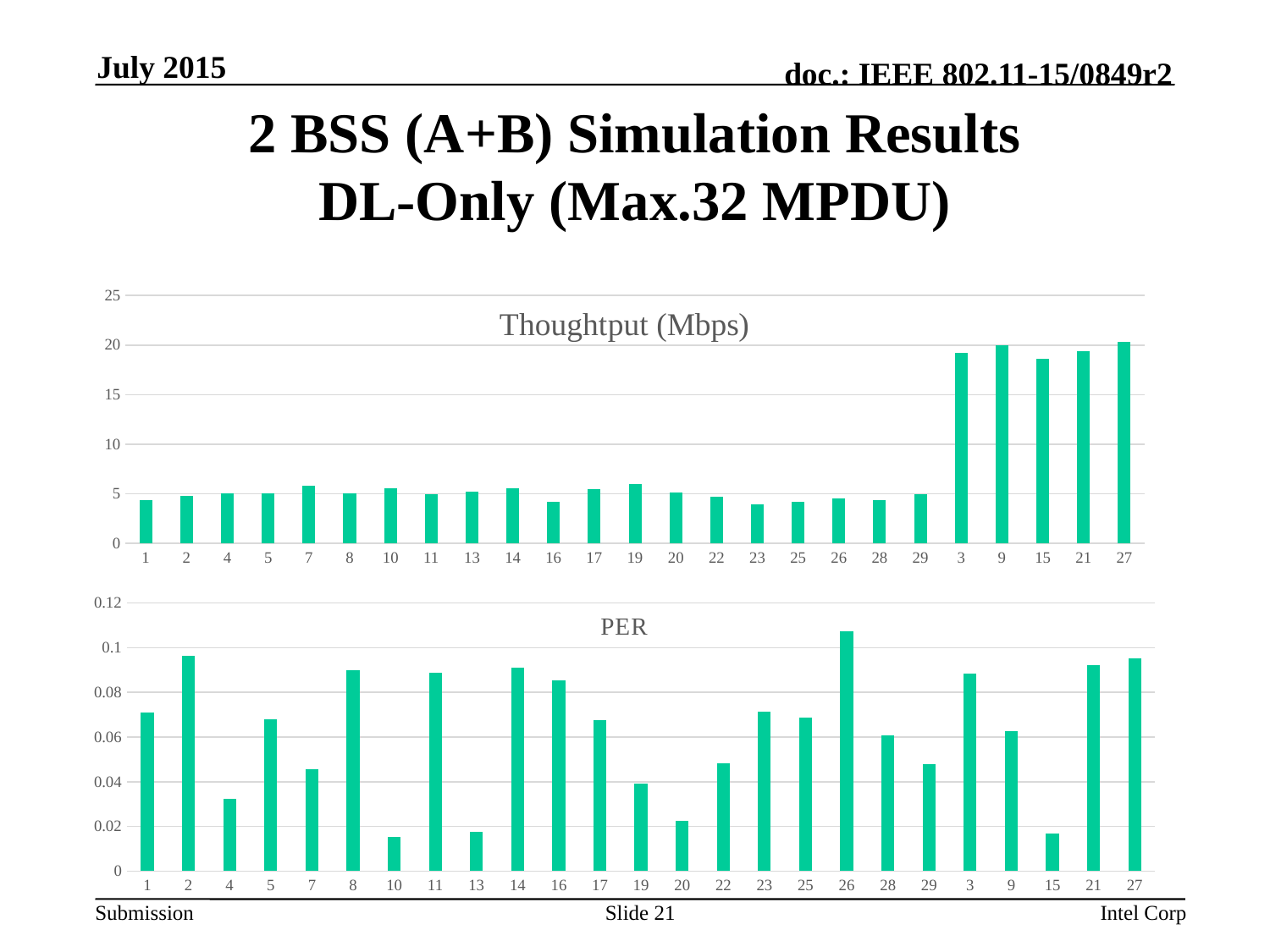
In the "Thoughtput (Mbps)" chart, which has the larger value, category 9 or category 1? 9 In the "Thoughtput (Mbps)" chart, how many categories are shown on the x axis? 25 In the "Thoughtput (Mbps)" chart, is the value for category 23 greater or less than 5? less In the "Thoughtput (Mbps)" chart, is the value for category 3 greater or less than 15? greater In the "PER" chart, is the value for category 26 greater or less than 0.1? greater In the "PER" chart, which category has the highest value? 26 In the "PER" chart, which has the larger value, category 2 or category 4? 2 What kind of chart is the top chart titled "Thoughtput (Mbps)"? bar chart What is the title of the top chart on the slide? Thoughtput (Mbps)